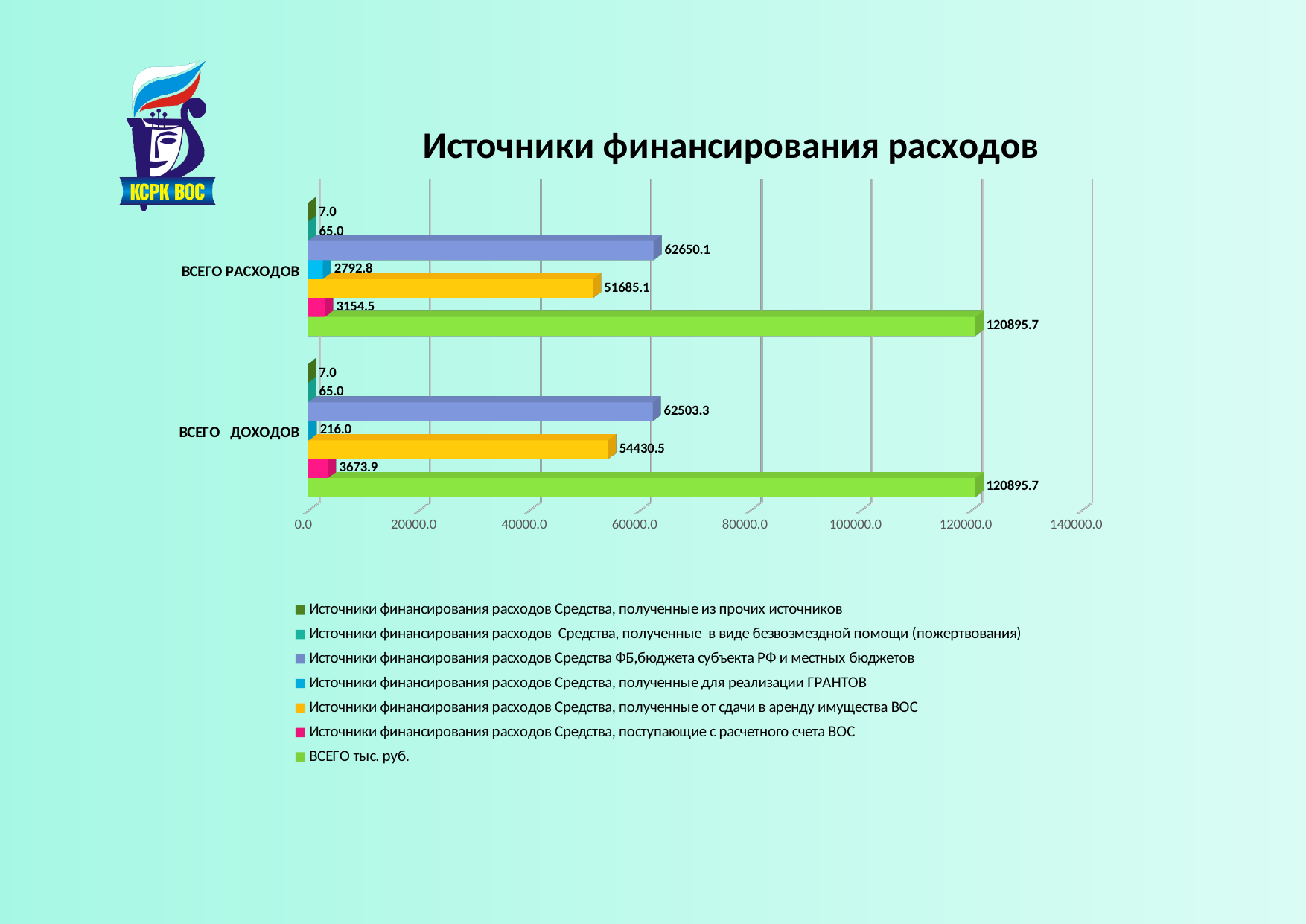
What is the value of 'Средства, полученные от сдачи в аренду имущества ВОС' for ВСЕГО ДОХОДОВ? 54430.5 Is the value of 'Средства ФБ,бюджета субъекта РФ и местных бюджетов' for ВСЕГО РАСХОДОВ greater or less than 60000.0? greater What is the value of 'Средства, полученные для реализации ГРАНТОВ' for ВСЕГО РАСХОДОВ? 2792.8 How many categories are shown on the vertical axis? 2 Which is larger: 'Средства, поступающие с расчетного счета ВОС' for ВСЕГО ДОХОДОВ or for ВСЕГО РАСХОДОВ? ВСЕГО ДОХОДОВ How many series does the legend list? 7 What is the title of the chart? Источники финансирования расходов What is the value of 'Средства ФБ,бюджета субъекта РФ и местных бюджетов' for ВСЕГО ДОХОДОВ? 62503.3 What is the difference between 'Средства, полученные от сдачи в аренду имущества ВОС' for ВСЕГО ДОХОДОВ and for ВСЕГО РАСХОДОВ? 2745.4 What type of chart is shown on the slide? bar chart What is the value of 'ВСЕГО тыс. руб.' for ВСЕГО РАСХОДОВ? 120895.7 Which series has the lowest value for ВСЕГО ДОХОДОВ? Средства, полученные из прочих источников